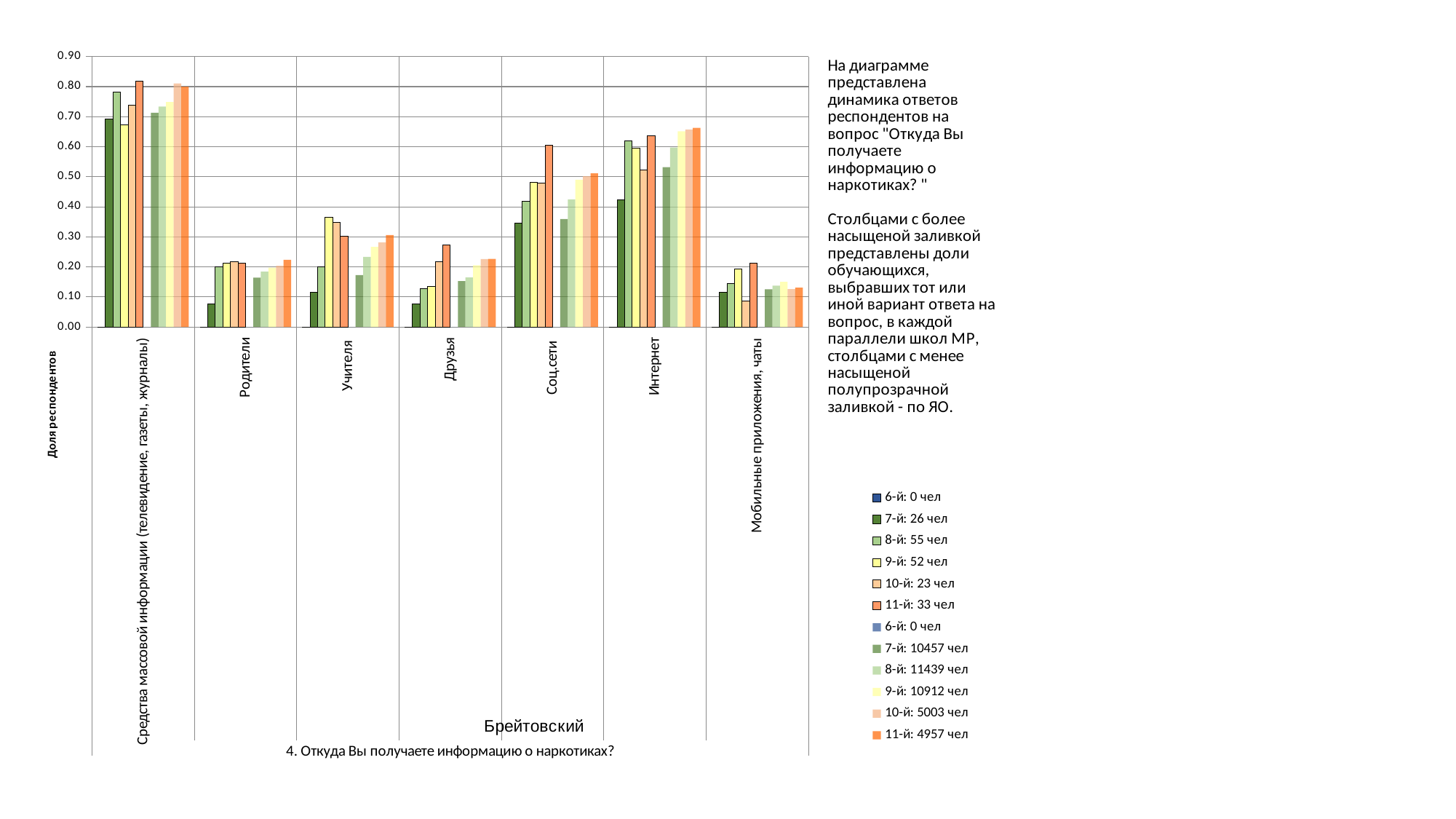
What kind of chart is shown on the slide? Bar chart Which category has the tallest bars in the chart? Средства массовой информации (телевидение, газеты, журналы) How many answer categories are shown along the x axis of the chart? 7 How many series does the chart's legend list? 12 What is the title of the chart shown at the bottom of the plot? 4. Откуда Вы получаете информацию о наркотиках? Is the value for the '9-й: 52 чел' series in the 'Учителя' category greater or less than 0.30? greater What is the label of the chart's vertical axis? Доля респондентов Is the value for the '7-й: 26 чел' series in the 'Средства массовой информации' category greater or less than 0.60? greater For the '7-й: 26 чел' series, which is larger: the value for 'Интернет' or for 'Соц.сети'? Интернет Is the value for the '7-й: 26 чел' series in the 'Родители' category greater or less than 0.10? less